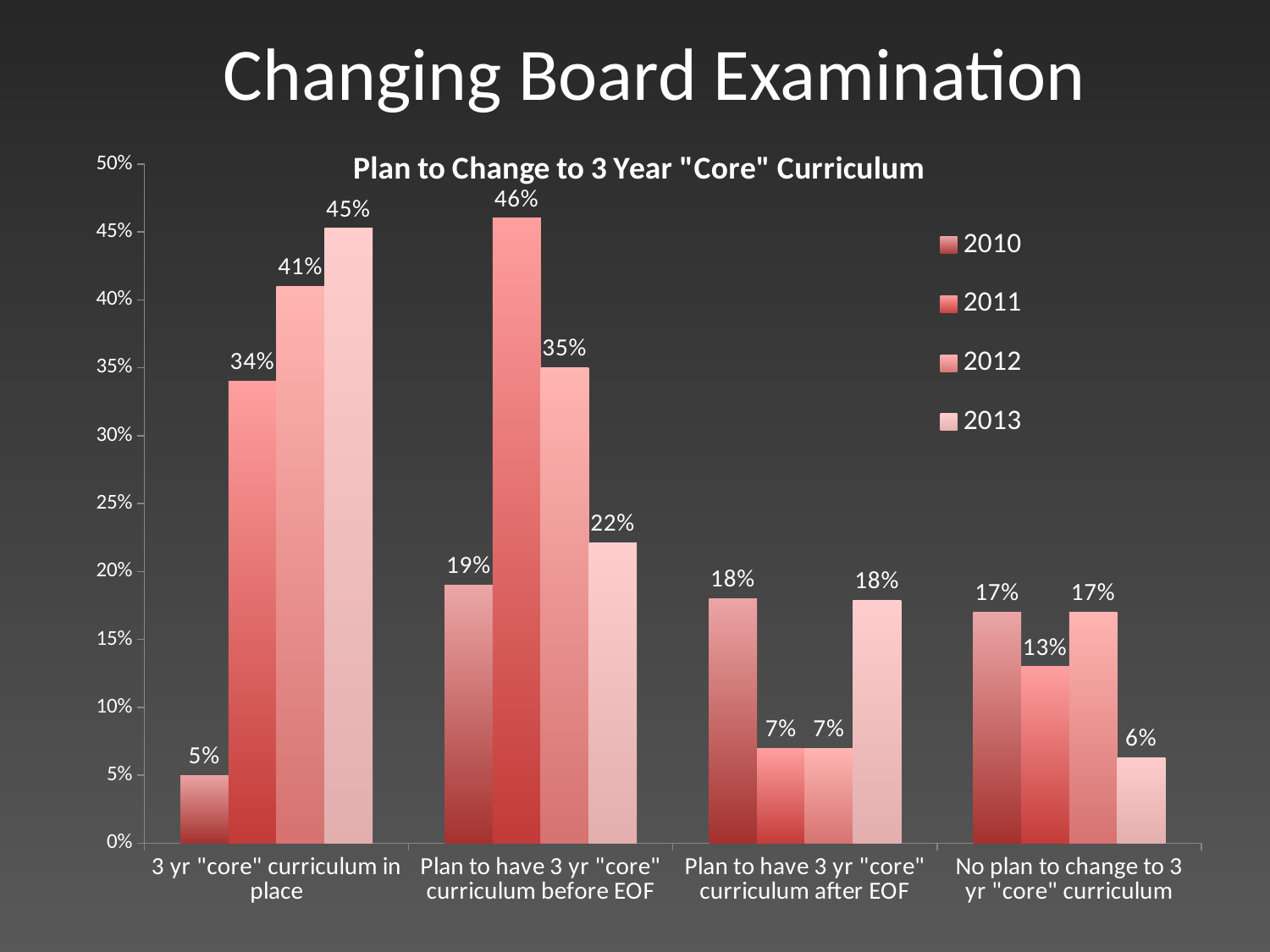
Which category has the highest 2010 value? Plan to have 3 yr "core" curriculum before EOF Which category has the lowest 2013 value? No plan to change to 3 yr "core" curriculum What is the 2013 value for "3 yr "core" curriculum in place"? 45% What kind of chart is shown on the slide? Bar chart What is the 2012 value for "No plan to change to 3 yr "core" curriculum"? 17% Which is larger for "Plan to have 3 yr "core" curriculum after EOF": the 2010 value or the 2011 value? 2010 What is the difference between the 2013 and 2010 values for "3 yr "core" curriculum in place"? 40% How many series does the legend list? 4 How many categories are shown on the x axis? 4 What is the 2011 value for "Plan to have 3 yr "core" curriculum before EOF"? 46% What is the title of the chart? Plan to Change to 3 Year "Core" Curriculum Do the values for "3 yr "core" curriculum in place" rise or fall from 2010 to 2013? Rise